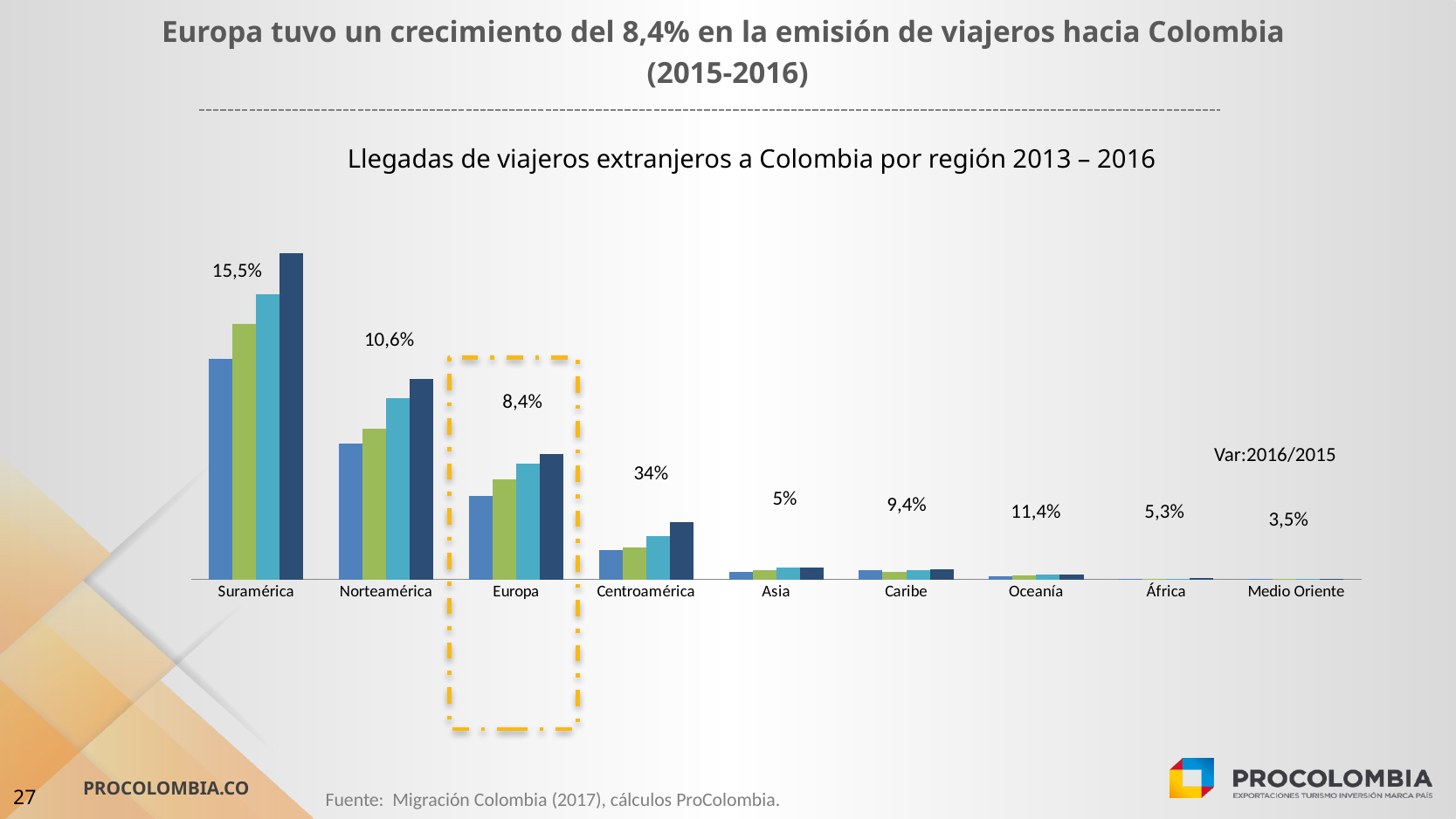
What Var:2016/2015 value is printed above Centroamérica? 34% What kind of chart is shown on the slide? Bar chart What is the title of the chart? Llegadas de viajeros extranjeros a Colombia por región 2013 – 2016 Which region has the highest Var:2016/2015 percentage printed on the chart? Centroamérica Which region is highlighted with a dashed orange box on the chart? Europa How many regions are shown on the x axis of the chart? 9 Do the bars for Suramérica rise or fall from the first bar to the fourth bar? Rise Which region has the tallest bars in the chart? Suramérica Which region has taller bars, Europa or Centroamérica? Europa What Var:2016/2015 value is printed above Europa? 8,4% What Var:2016/2015 value is printed above Oceanía? 11,4% Which region has the lowest Var:2016/2015 percentage printed on the chart? Medio Oriente